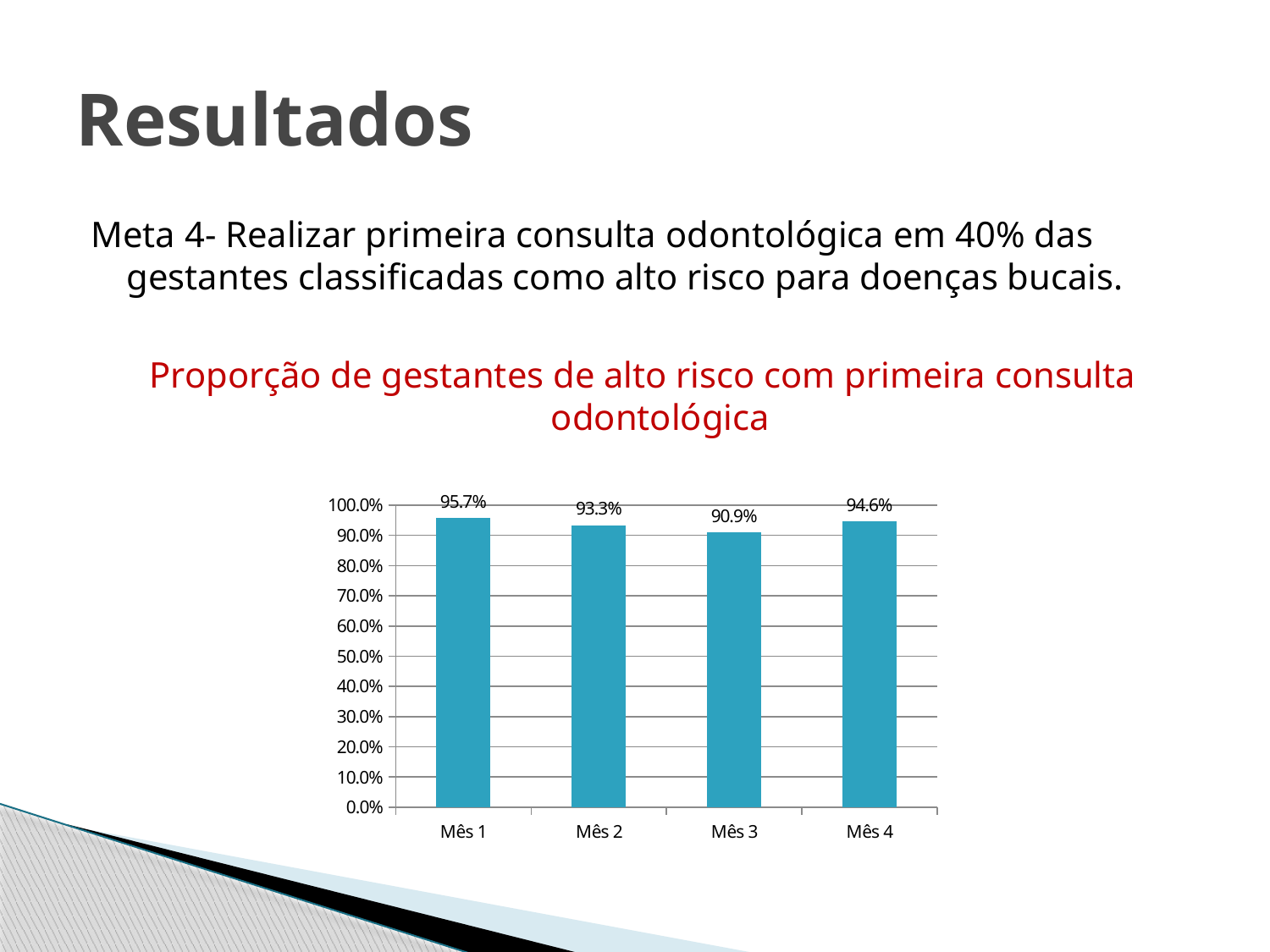
Which is larger, the value for Mês 2 or the value for Mês 4? Mês 4 What is the difference between the values for Mês 1 and Mês 3? 4.8% What is the value for Mês 1? 95.7% Which month has the highest value? Mês 1 What is the value for Mês 3? 90.9% Is the value for Mês 2 greater or less than 90.0%? greater Which month has the lowest value? Mês 3 Does the value rise or fall from Mês 1 to Mês 3? fall What kind of chart is shown on the slide? bar chart What is the value for Mês 4? 94.6% How many months are shown on the x axis? 4 What is the title of the chart? Proporção de gestantes de alto risco com primeira consulta odontológica